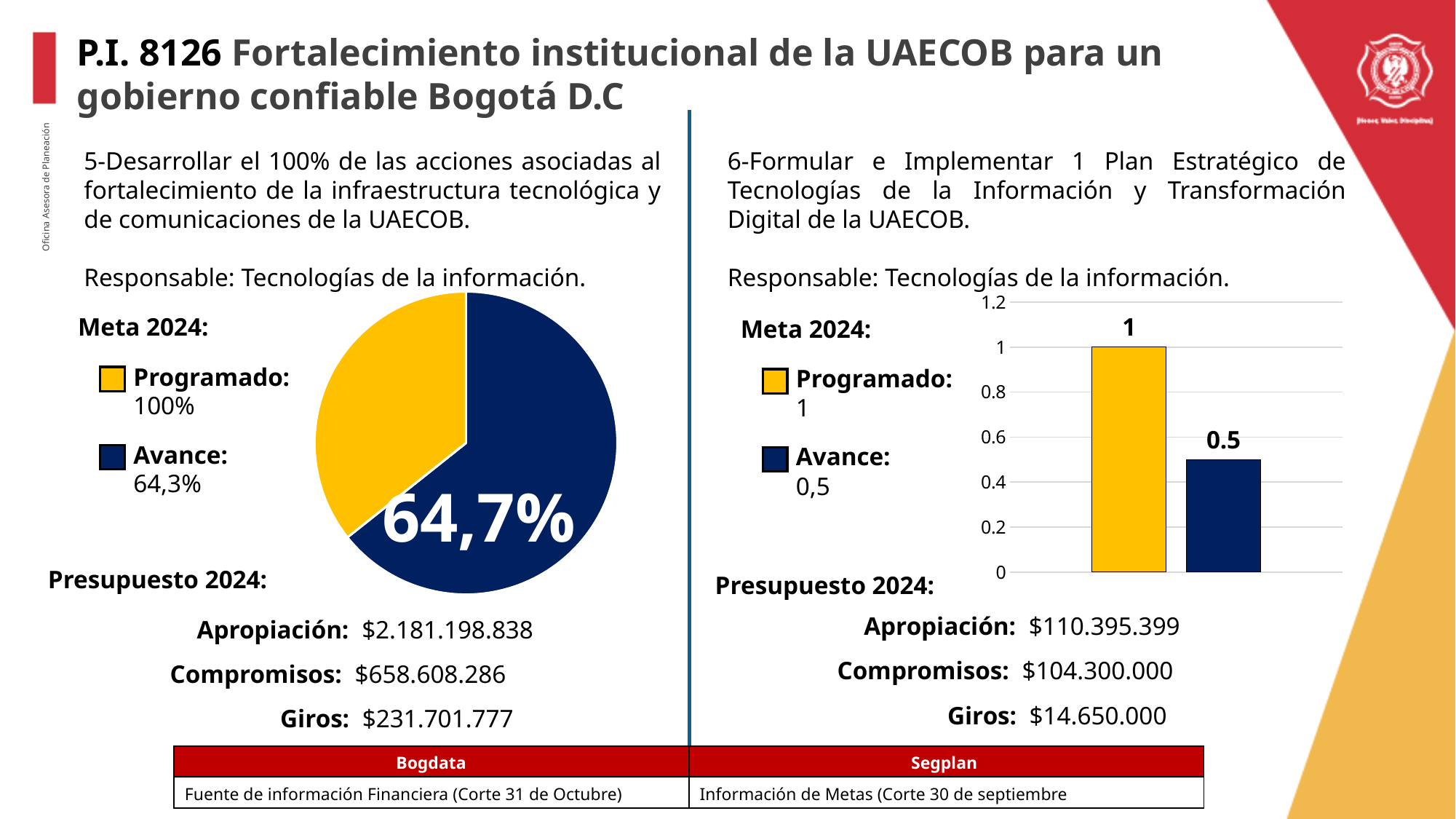
In the bar chart on the right, how many bars are plotted? 2 In the pie chart on the left, which slice is larger, the yellow one or the dark blue one? The dark blue one In the bar chart on the right, what is the highest value shown on the vertical axis? 1.2 In the bar chart on the right, what value is shown for the Programado bar? 1 In the bar chart on the right, is the Avance bar greater or less than 0.4? greater In the bar chart on the right, which bar is taller, Programado or Avance? Programado What kind of chart is shown on the right side of the slide? Bar chart What kind of chart is shown on the left side of the slide? Pie chart In the pie chart on the left, what colour represents Programado? Yellow In the bar chart on the right, what is the difference between the Programado and Avance values? 0.5 In the bar chart on the right, what value is shown for the Avance bar? 0.5 In the pie chart on the left, what percentage is printed on the dark blue slice? 64,7%